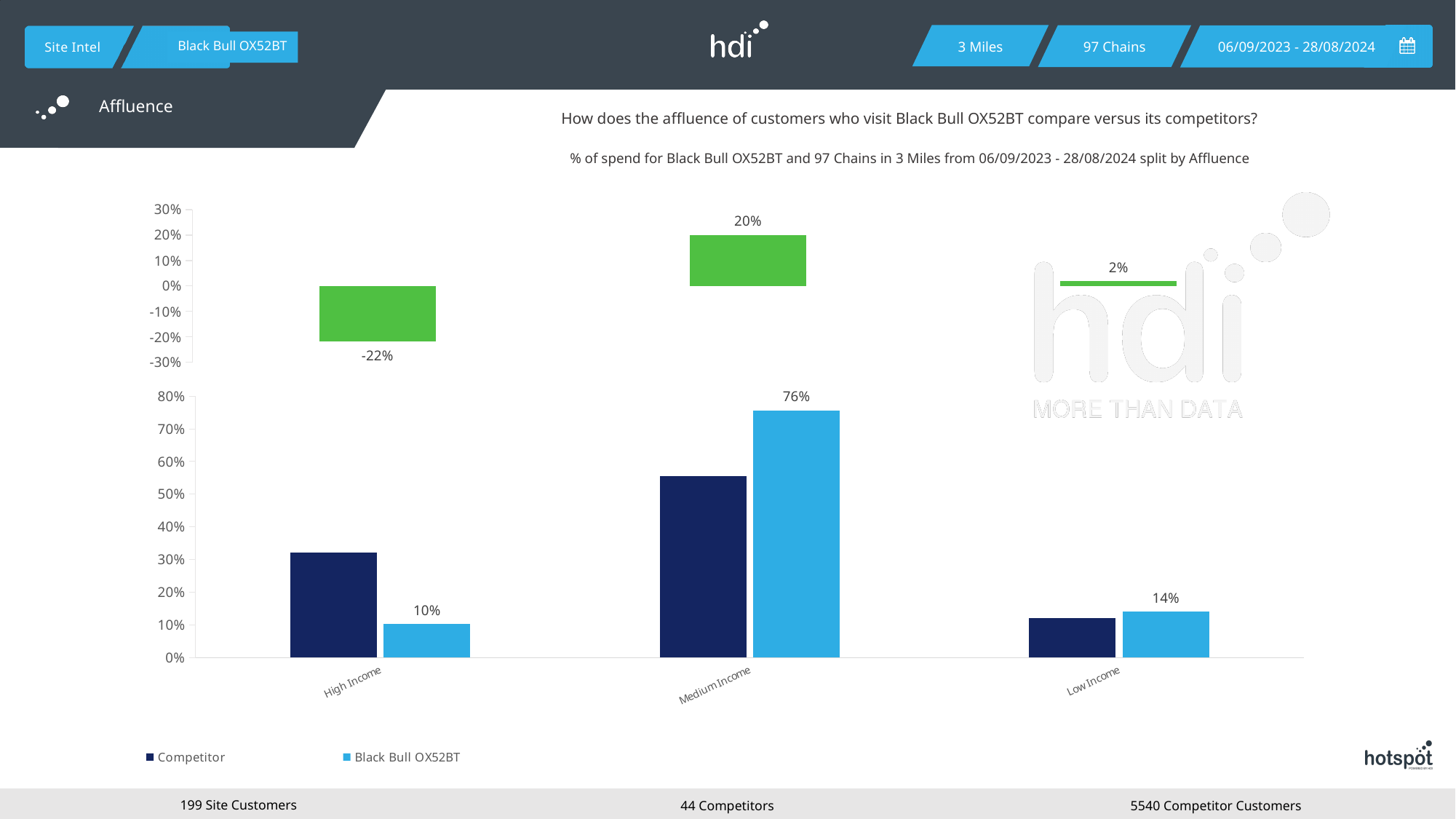
On the bottom chart, which is larger in the Medium Income category: Competitor or Black Bull OX52BT? Black Bull OX52BT On the top chart, what is the value shown for the High Income category? -22% On the top chart, what is the value shown for the Medium Income category? 20% On the bottom chart, which category has the highest value for Black Bull OX52BT? Medium Income What kind of chart is the bottom chart? Bar chart On the bottom chart, what is the difference between the Black Bull OX52BT values for Medium Income and High Income? 66% On the top chart, what is the value shown for the Low Income category? 2% On the bottom chart, what is the value for Black Bull OX52BT in the High Income category? 10% How many series does the legend of the bottom chart list? 2 On the bottom chart, is the Competitor value for High Income greater or less than 20%? greater On the bottom chart, what is the value for Black Bull OX52BT in the Medium Income category? 76% On the bottom chart, what is the value for Black Bull OX52BT in the Low Income category? 14%